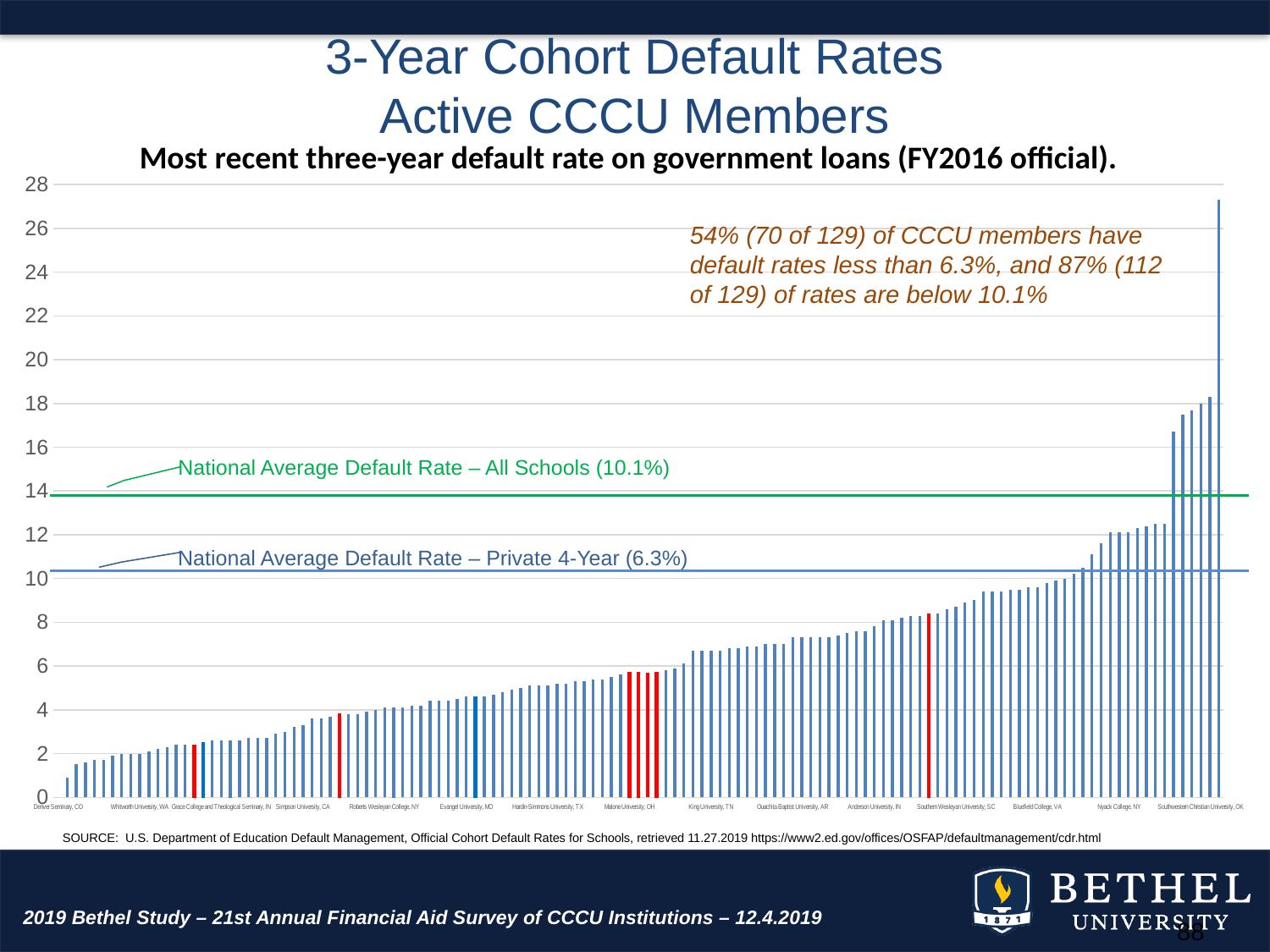
Is the default rate for King University, TN greater or less than 4? greater Is the default rate for Malone University, OH greater or less than 8? less What kind of chart is shown on the slide? bar chart Which school has the lowest 3-year cohort default rate on the chart? Denver Seminary, CO How many CCCU members are represented in the chart? 129 Is the default rate for Southwestern Christian University, OK greater or less than 26? less According to the annotation, what percentage of CCCU members have default rates below 10.1%? 87% Which has the larger default rate, Nyack College, NY or Whitworth University, WA? Nyack College, NY Do the default rates rise or fall moving from left to right along the x axis? rise What value is given for the National Average Default Rate – Private 4-Year line? 6.3%